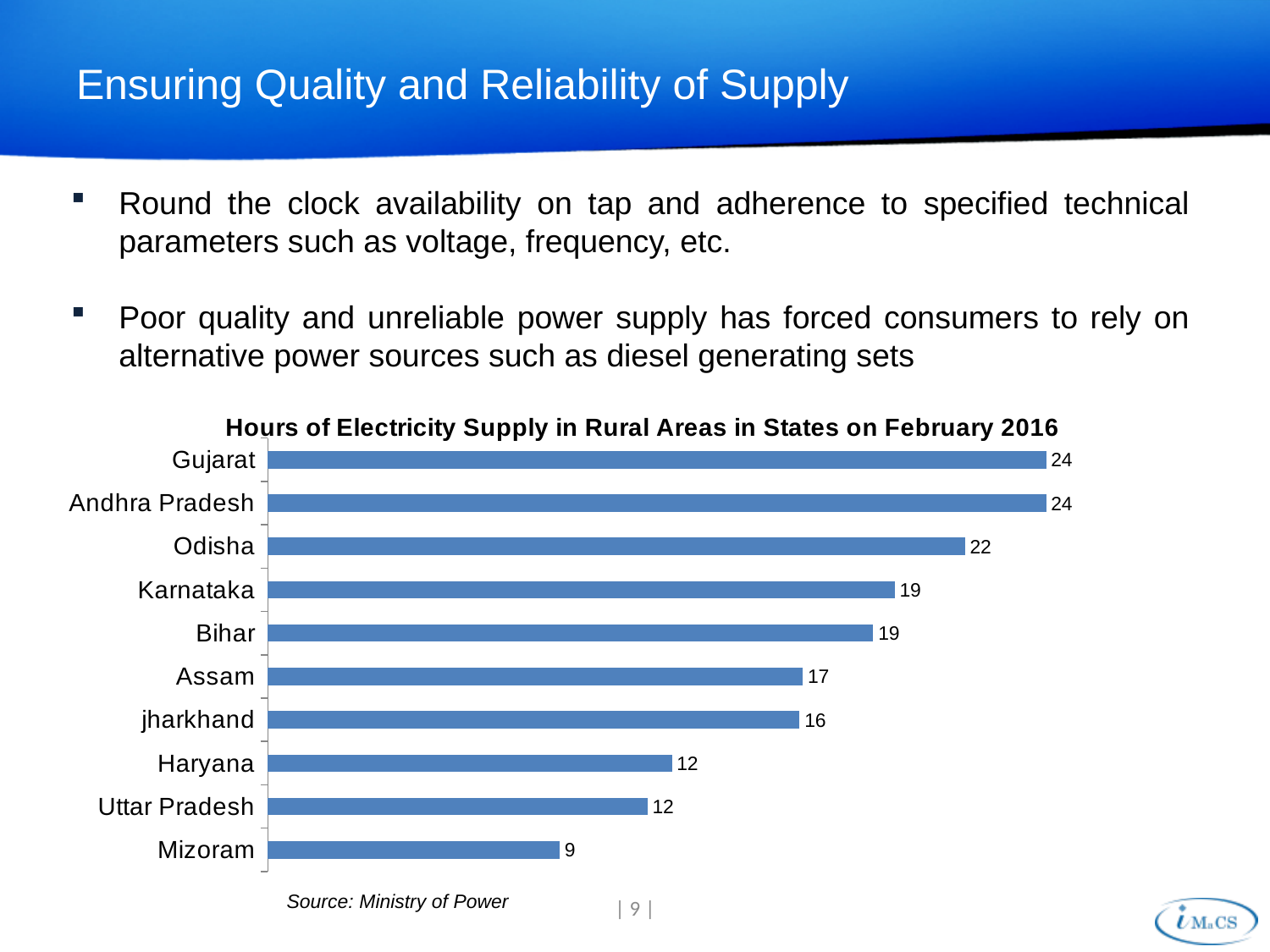
What is the value for Odisha? 22 What is the difference between the values for Gujarat and Mizoram? 15 Which is larger, the value for Bihar or the value for Haryana? Bihar What kind of chart is shown on the slide? bar chart How many states are shown in the chart? 10 Which state has the lowest value? Mizoram What is the value for jharkhand? 16 Which is larger, the value for Assam or the value for Odisha? Odisha What is the value for Assam? 17 What is the value for Mizoram? 9 What is the difference between the values for Odisha and Karnataka? 3 What is the title of the chart? Hours of Electricity Supply in Rural Areas in States on February 2016